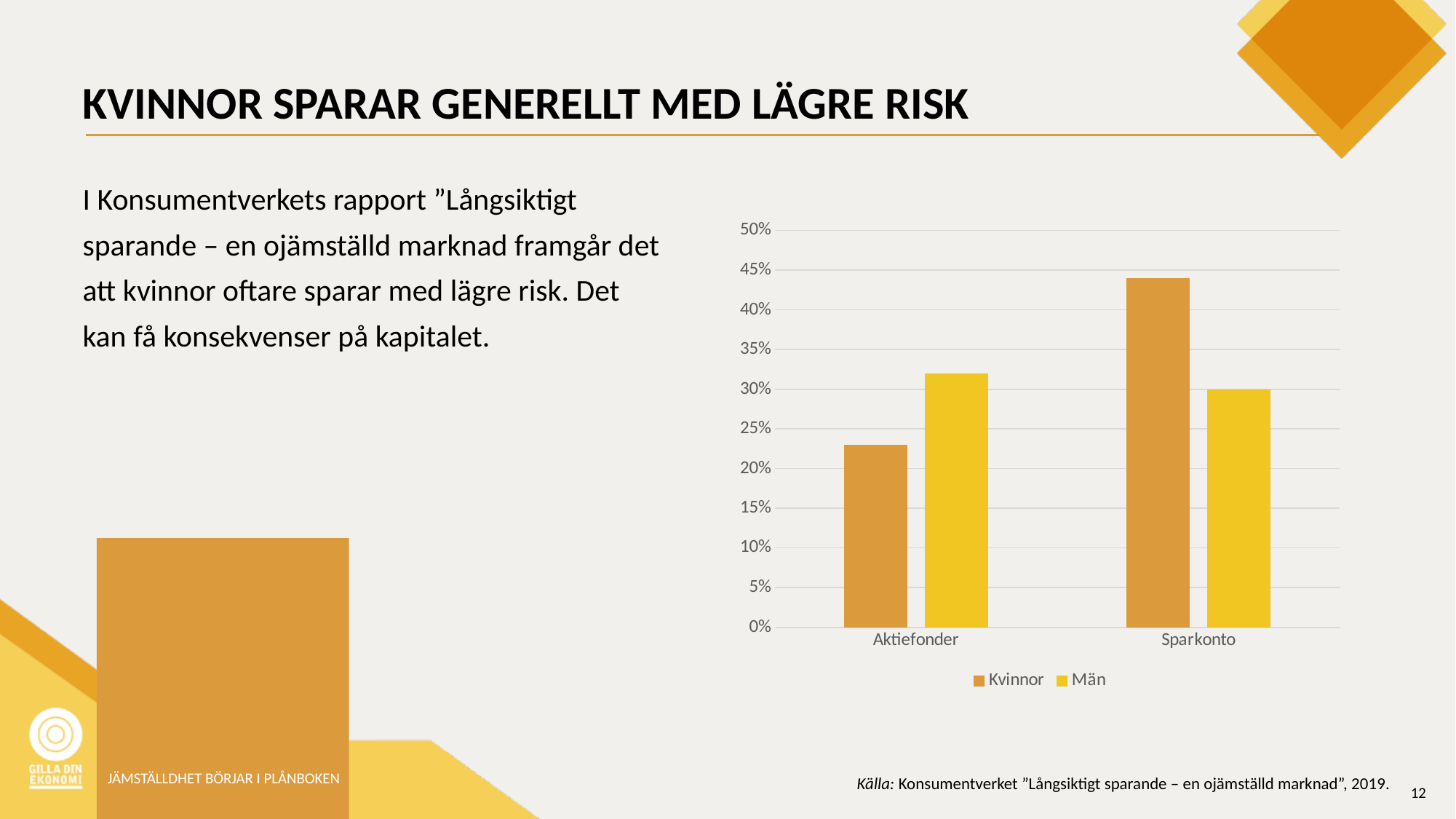
How many series does the chart legend list? 2 How many categories are shown on the x axis of the chart? 2 Which bar in the chart is the shortest? Kvinnor, Aktiefonder What is the highest value shown on the chart's vertical axis? 50% What kind of chart is shown on the slide? bar chart Which series has the higher value for Aktiefonder, Kvinnor or Män? Män Is the value for Män in Aktiefonder greater or less than 30%? greater Which bar in the chart is the tallest? Kvinnor, Sparkonto Is the value for Kvinnor in Sparkonto greater or less than 40%? greater What are the two legend entries of the chart? Kvinnor and Män Which series has the higher value for Sparkonto, Kvinnor or Män? Kvinnor Is the value for Kvinnor in Aktiefonder greater or less than 25%? less